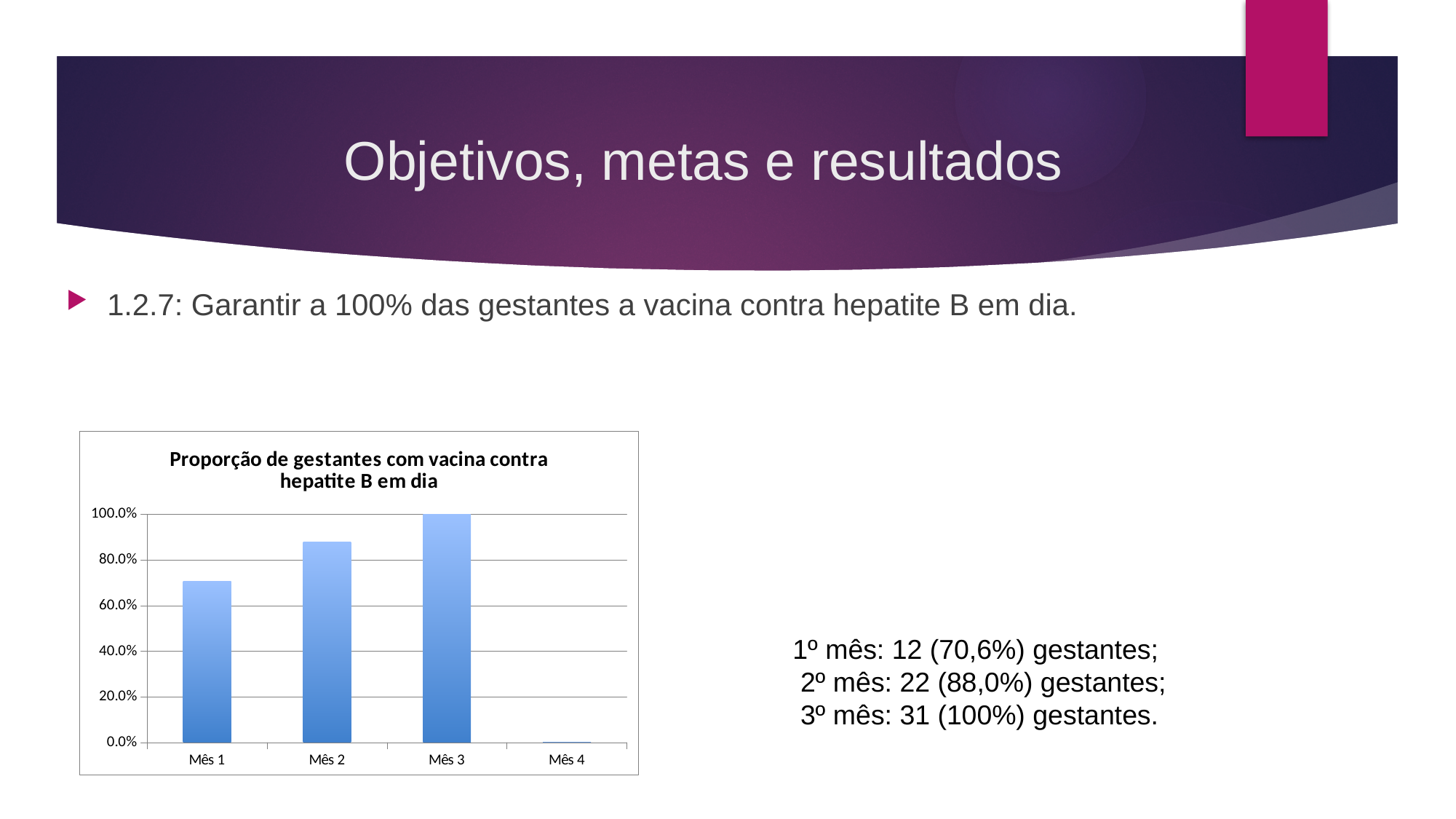
Which is larger, the value for Mês 1 or the value for Mês 2? Mês 2 What is the value for Mês 3 in the chart? 100.0% Do the values rise or fall from Mês 1 to Mês 3? rise How many categories are shown on the x axis of the chart? 4 Is the value for Mês 1 greater or less than 80.0%? less Which month has the lowest value in the chart? Mês 4 Is the value for Mês 4 greater or less than 20.0%? less What is the title of the chart? Proporção de gestantes com vacina contra hepatite B em dia Is the value for Mês 1 greater or less than 60.0%? greater What kind of chart is shown on the slide? bar chart Which month has the highest value in the chart? Mês 3